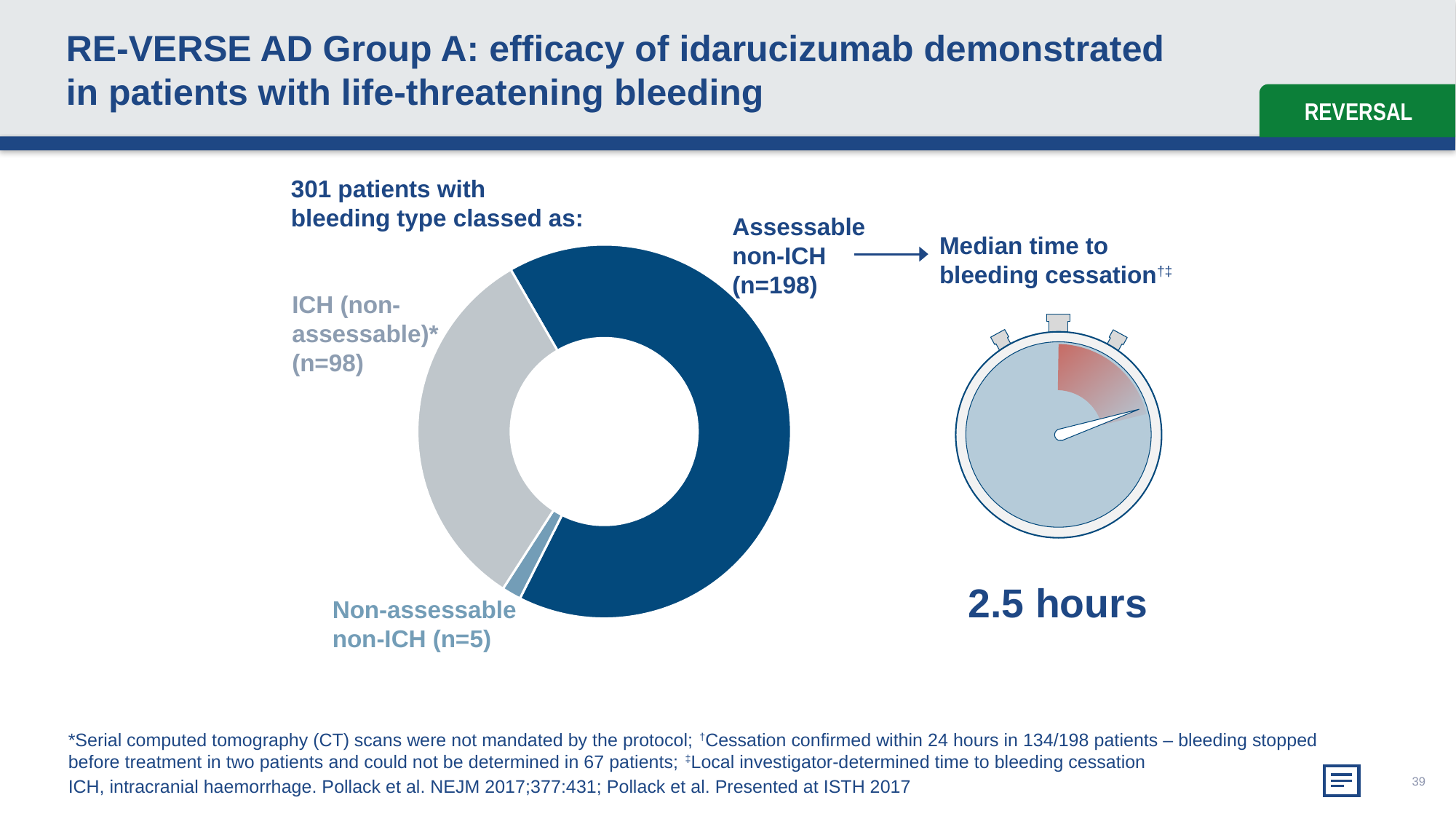
Which segment is larger: ICH (non-assessable) or Non-assessable non-ICH? ICH (non-assessable) How many patients are in the ICH (non-assessable) segment of the donut chart? 98 Which segment of the donut chart has the smallest number of patients? Non-assessable non-ICH What is the total number of patients represented in the donut chart? 301 How many patients are in the Assessable non-ICH segment of the donut chart? 198 What kind of chart is used to show the bleeding type classification? Donut (pie) chart What is the median time to bleeding cessation shown next to the stopwatch? 2.5 hours What is the difference in patient numbers between the Assessable non-ICH and ICH (non-assessable) segments? 100 How many patients are in the Non-assessable non-ICH segment of the donut chart? 5 Which segment of the donut chart has the largest number of patients? Assessable non-ICH What colour is the Assessable non-ICH segment of the donut chart? Dark blue How many segments does the donut chart have? 3